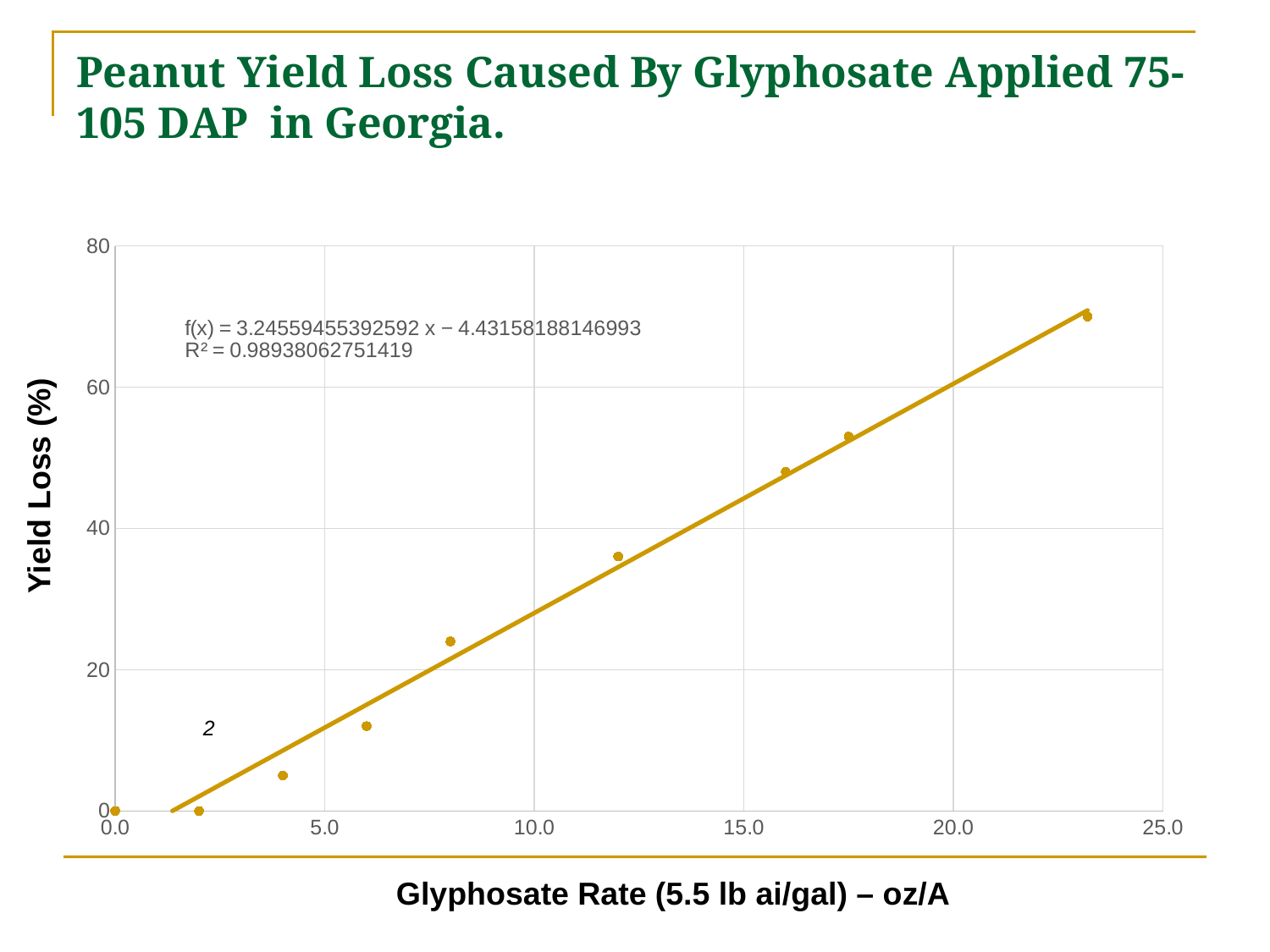
Is the yield loss at a glyphosate rate of 8 oz/A greater or less than 20? greater Is the yield loss at a glyphosate rate of 4 oz/A greater or less than 20? less What is the R² value shown for the trendline? 0.98938062751419 Is the yield loss at the highest plotted glyphosate rate (about 23 oz/A) greater or less than 60? greater What kind of chart is shown on the slide? scatter chart How many data points are plotted on the chart? 9 What is the label of the y axis? Yield Loss (%) Do the yield loss values rise or fall as the glyphosate rate increases along the x axis? rise What is the yield loss at a glyphosate rate of 0.0 oz/A? 0